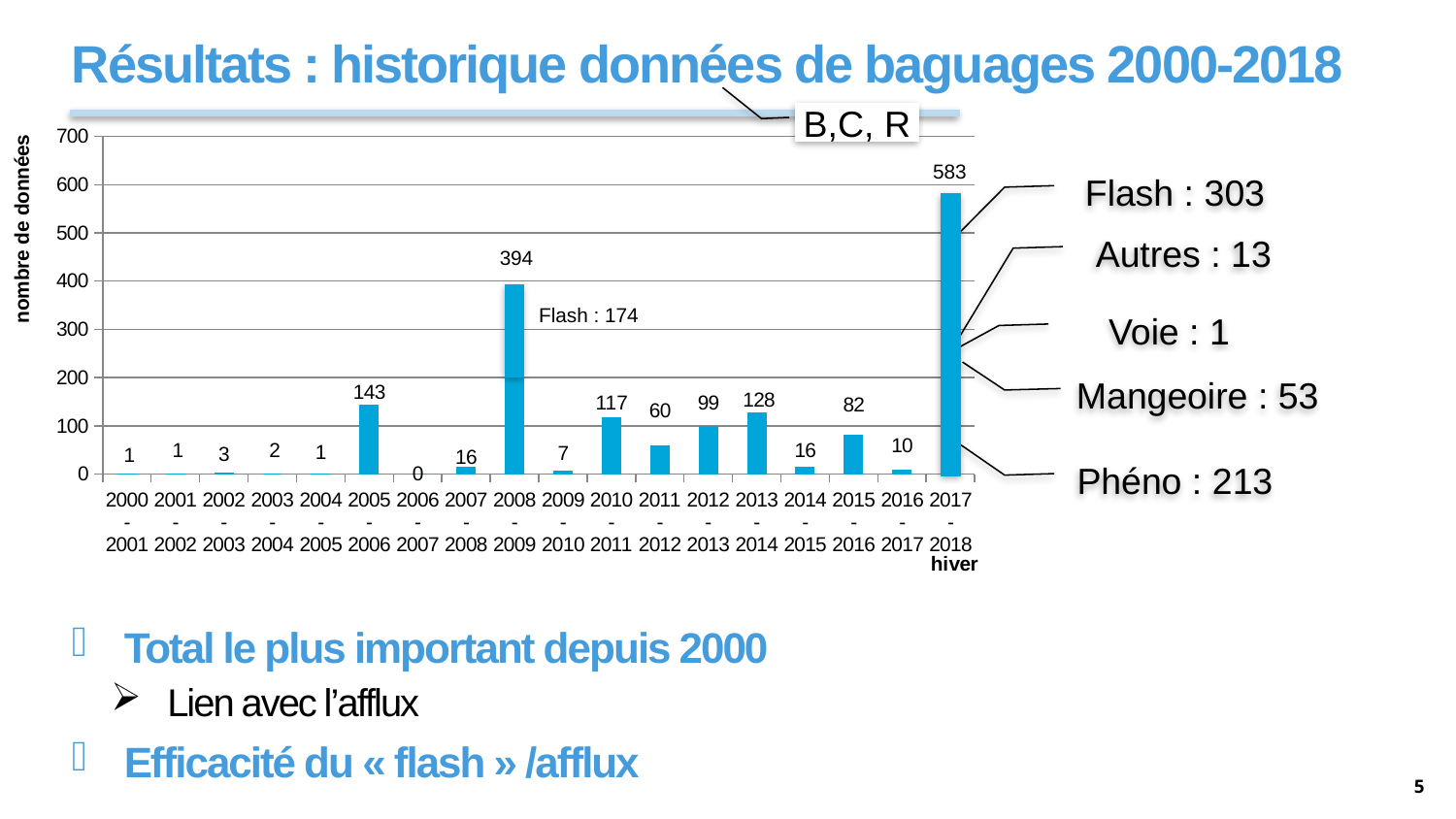
Which winter has the lowest number of data? 2006-2007 What is the value for the 2017-2018 winter? 583 Is the value for 2015-2016 greater or less than 100? less What is the difference between the values for 2017-2018 and 2008-2009? 189 What kind of chart is shown on the slide? bar chart What is the value for the 2008-2009 winter? 394 Which is larger, the value for 2010-2011 or the value for 2013-2014? 2013-2014 How many winters are shown on the x axis? 18 What is the label of the y axis? nombre de données Which winter has the highest number of data? 2017-2018 What is the value for the 2011-2012 winter? 60 What is the value for the 2005-2006 winter? 143